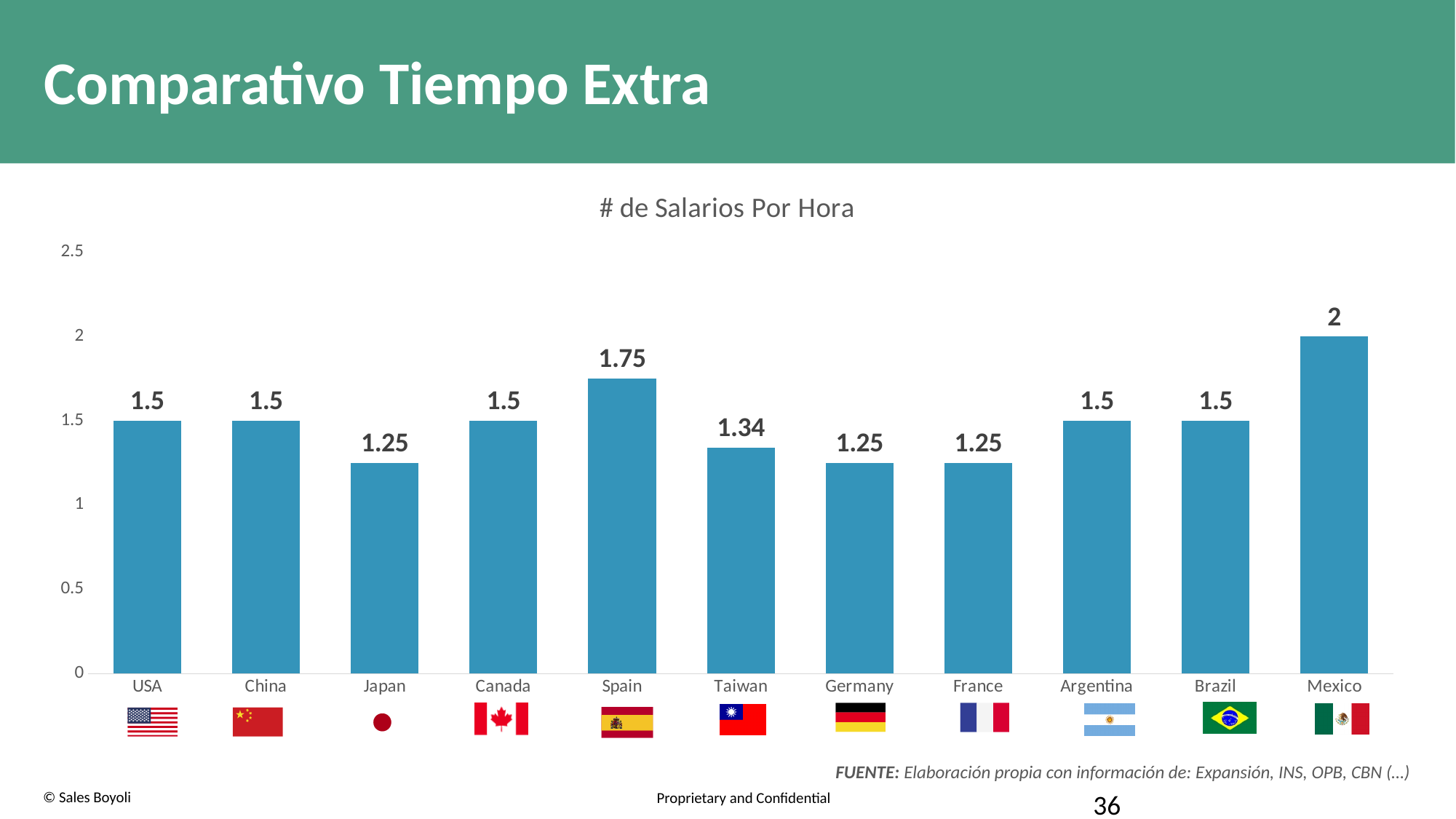
What is the value for Taiwan in the chart? 1.34 What kind of chart is shown on the slide? bar chart What is the difference between the values for Mexico and Spain? 0.25 What is the title of the chart? # de Salarios Por Hora What is the value for Spain in the chart? 1.75 What is the value for France in the chart? 1.25 How many countries are shown in the chart? 11 What is the value for Mexico in the chart? 2 What is the difference between the values for Taiwan and Germany? 0.09 Which country has the highest value in the chart? Mexico Is the value for Japan greater or less than 1.5? less Which is larger, the value for Spain or the value for Canada? Spain